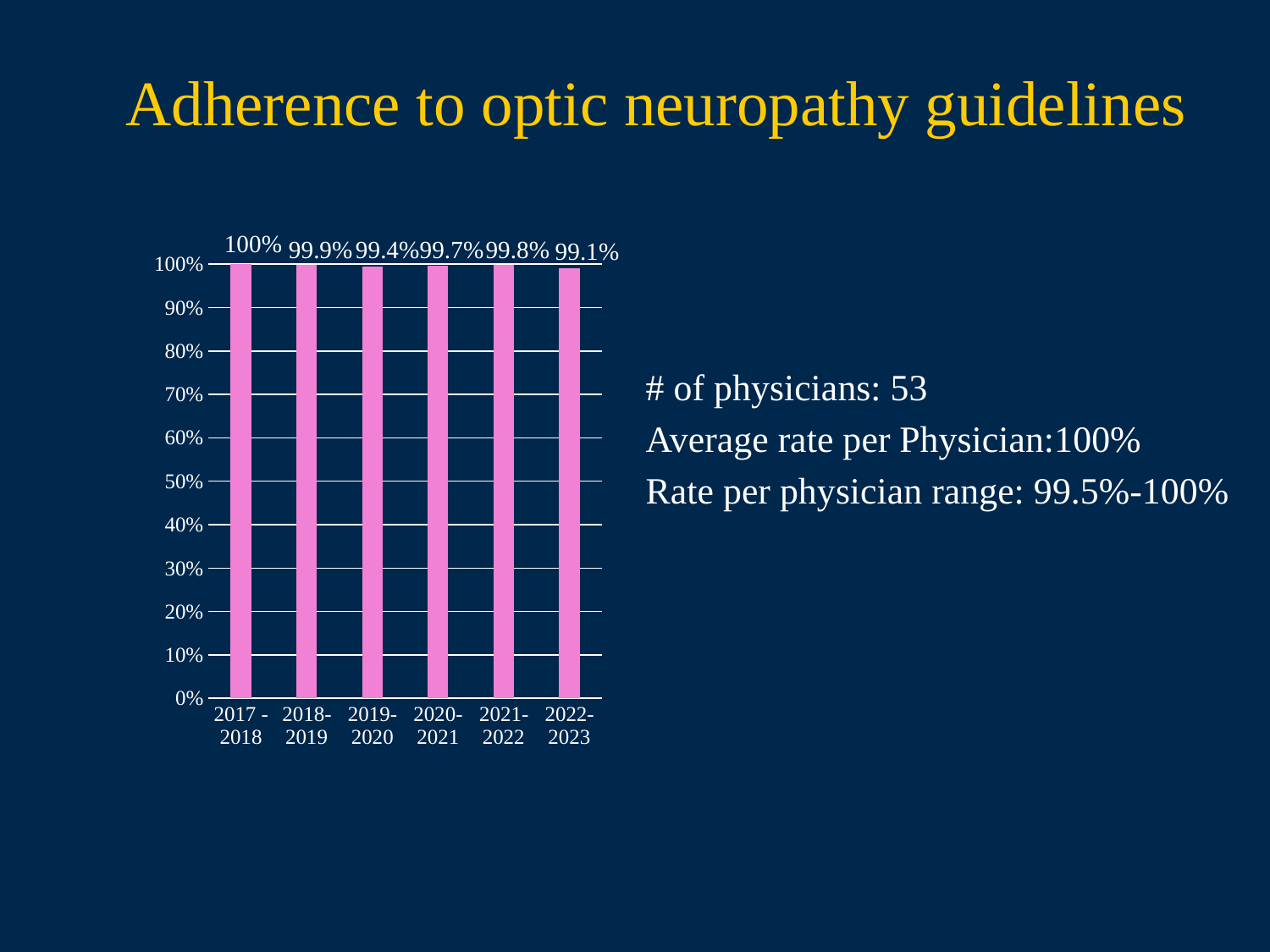
How many periods are shown on the x axis? 6 What is the difference between the values for 2017-2018 and 2022-2023? 0.9% Which period has the highest value? 2017-2018 Which period has the lowest value? 2022-2023 What kind of chart is shown on the slide? bar chart What is the value for 2019-2020? 99.4% What is the value for 2022-2023? 99.1% What is the value for 2021-2022? 99.8% Is the value for 2020-2021 greater or less than 90%? greater What is the title of the slide containing the chart? Adherence to optic neuropathy guidelines What is the value for 2017-2018? 100% Which is larger, the value for 2018-2019 or the value for 2019-2020? 2018-2019